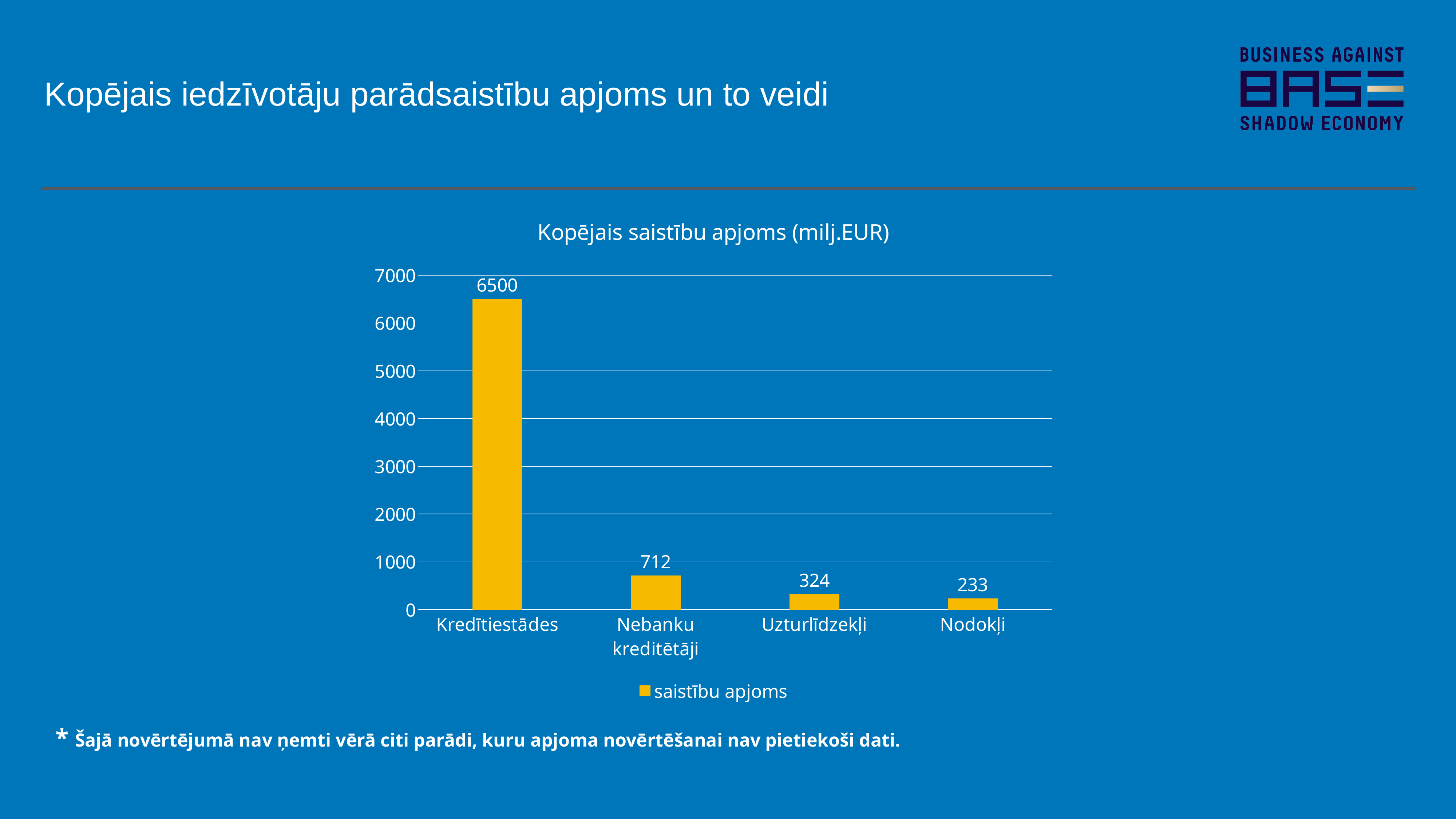
What is the value for Kredītiestādes? 6500 Which is larger, the value for Nebanku kreditētāji or the value for Uzturlīdzekļi? Nebanku kreditētāji Which category has the highest value? Kredītiestādes Which category has the lowest value? Nodokļi What kind of chart is shown on the slide? bar chart What is the value for Nodokļi? 233 What is the title of the chart? Kopējais saistību apjoms (milj.EUR) How many categories are shown on the x axis? 4 What is the difference between the values for Kredītiestādes and Nebanku kreditētāji? 5788 What is the difference between the values for Uzturlīdzekļi and Nodokļi? 91 What is the value for Uzturlīdzekļi? 324 What is the value for Nebanku kreditētāji? 712